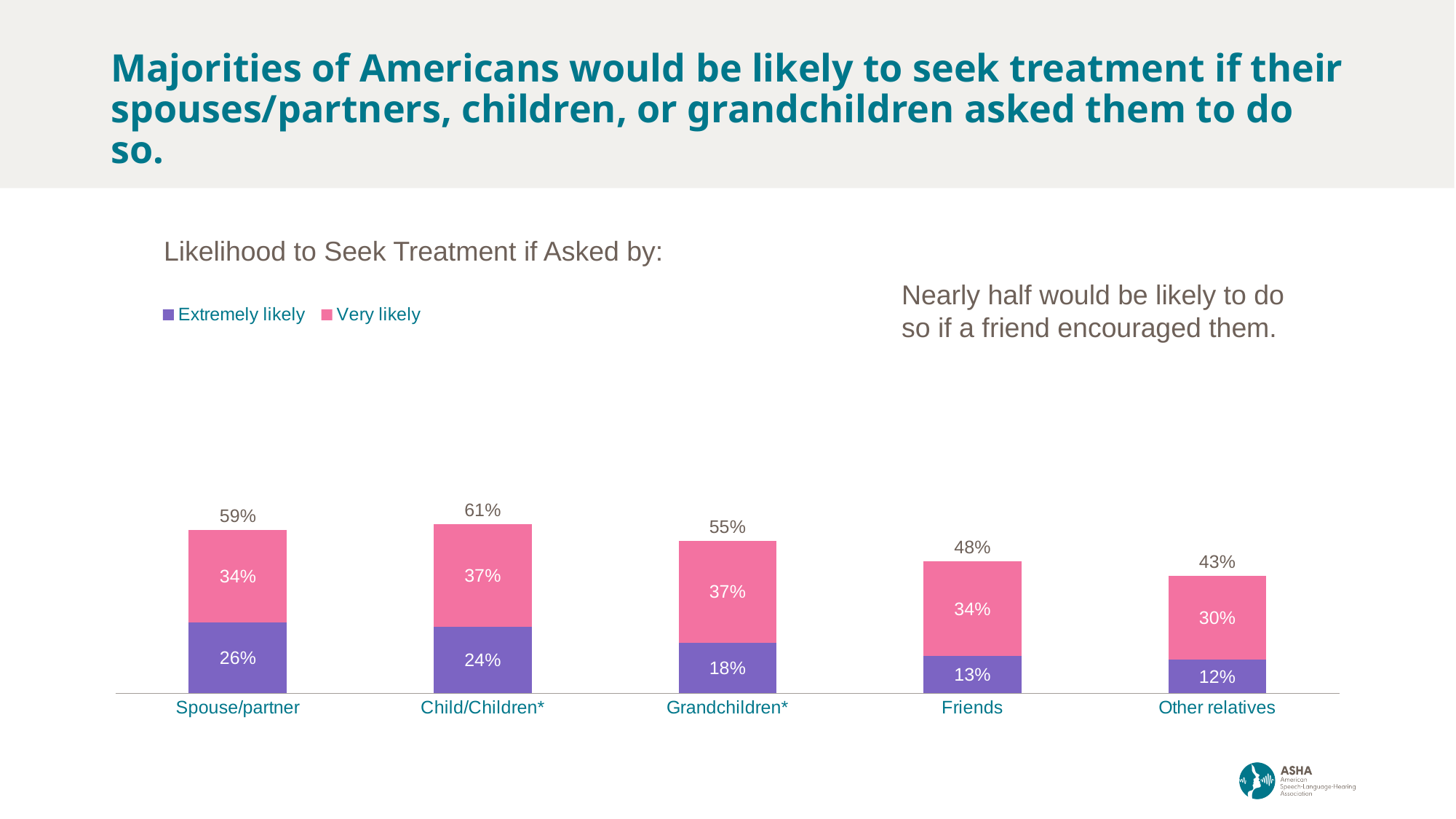
How many series does the legend list? 2 How many categories are shown on the x axis? 5 What is the 'Very likely' value for Grandchildren*? 37% Which category has the lowest 'Extremely likely' value? Other relatives What is the title of the chart? Likelihood to Seek Treatment if Asked by: What is the 'Extremely likely' value for Friends? 13% What kind of chart is shown? Stacked bar chart What is the 'Extremely likely' value for Spouse/partner? 26% What is the total of the stacked bar for Other relatives? 43% Which is larger: the 'Very likely' value for Friends or for Other relatives? Friends What is the difference between the 'Extremely likely' values for Spouse/partner and Grandchildren*? 8% Which category has the highest total likelihood? Child/Children*